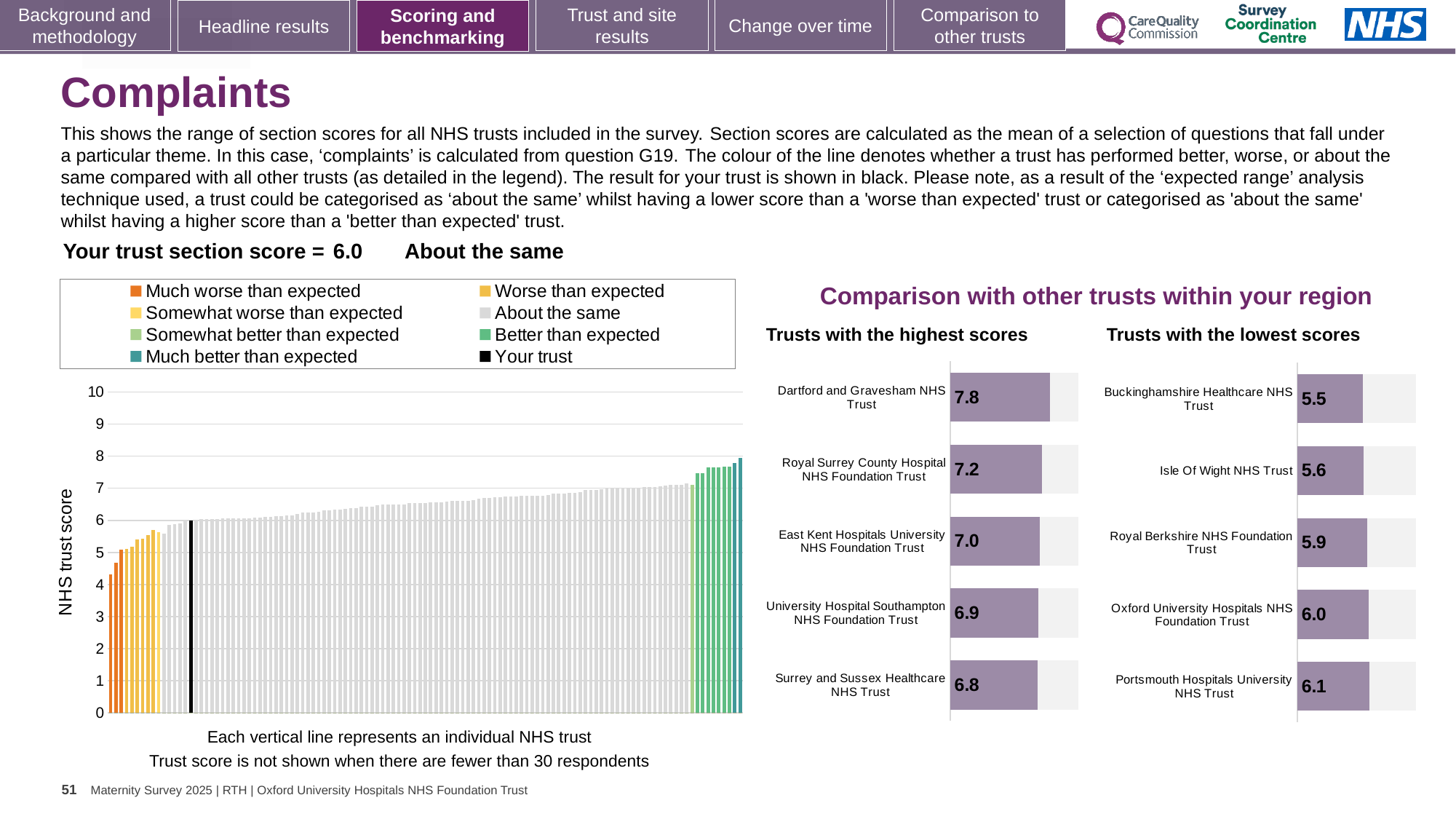
In the large chart on the left, what is the section score for your trust (shown in black)? 6.0 In the 'Trusts with the highest scores' chart, which trust has the highest score? Dartford and Gravesham NHS Trust In the 'Trusts with the highest scores' chart, what is the difference between the scores of Dartford and Gravesham NHS Trust and Surrey and Sussex Healthcare NHS Trust? 1.0 In the 'Trusts with the lowest scores' chart, what is the score for Isle Of Wight NHS Trust? 5.6 How many entries does the legend above the large chart on the left list? 8 What kind of chart is the large chart on the left with the 'NHS trust score' axis? Bar chart In the 'Trusts with the lowest scores' chart, what is the difference between the scores of Oxford University Hospitals NHS Foundation Trust and Buckinghamshire Healthcare NHS Trust? 0.5 How many trusts are shown in the 'Trusts with the highest scores' chart? 5 In the large chart on the left, do the trust scores rise or fall from left to right? Rise In the 'Trusts with the highest scores' chart, what is the score for Dartford and Gravesham NHS Trust? 7.8 In the 'Trusts with the lowest scores' chart, which has the larger score: Royal Berkshire NHS Foundation Trust or Portsmouth Hospitals University NHS Trust? Portsmouth Hospitals University NHS Trust In the 'Trusts with the lowest scores' chart, which trust has the lowest score? Buckinghamshire Healthcare NHS Trust